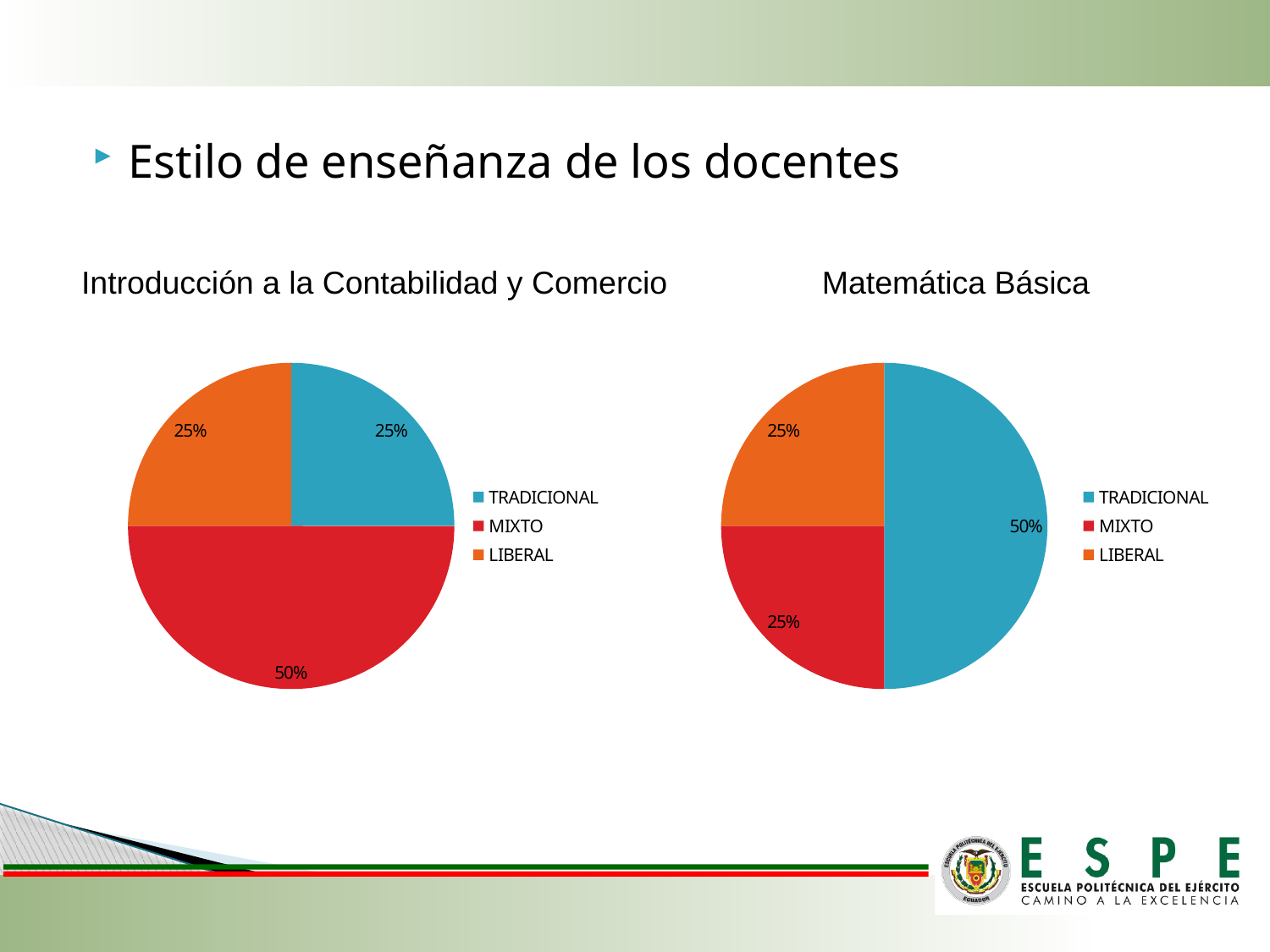
In the 'Introducción a la Contabilidad y Comercio' chart, which category has the largest slice? MIXTO In the 'Introducción a la Contabilidad y Comercio' chart, what is the difference between the MIXTO and LIBERAL shares? 25% What kind of chart is the 'Matemática Básica' chart? Pie chart In the 'Matemática Básica' chart, what share does LIBERAL have? 25% In the 'Matemática Básica' chart, which is larger, TRADICIONAL or MIXTO? TRADICIONAL How many categories does the 'Introducción a la Contabilidad y Comercio' chart show? 3 In the 'Introducción a la Contabilidad y Comercio' chart, what share does MIXTO have? 50% In the 'Matemática Básica' chart, what share does TRADICIONAL have? 50% In the 'Matemática Básica' chart, which category has the largest slice? TRADICIONAL How many entries does the legend of the 'Matemática Básica' chart list? 3 In the 'Matemática Básica' chart, which colour represents LIBERAL? Orange